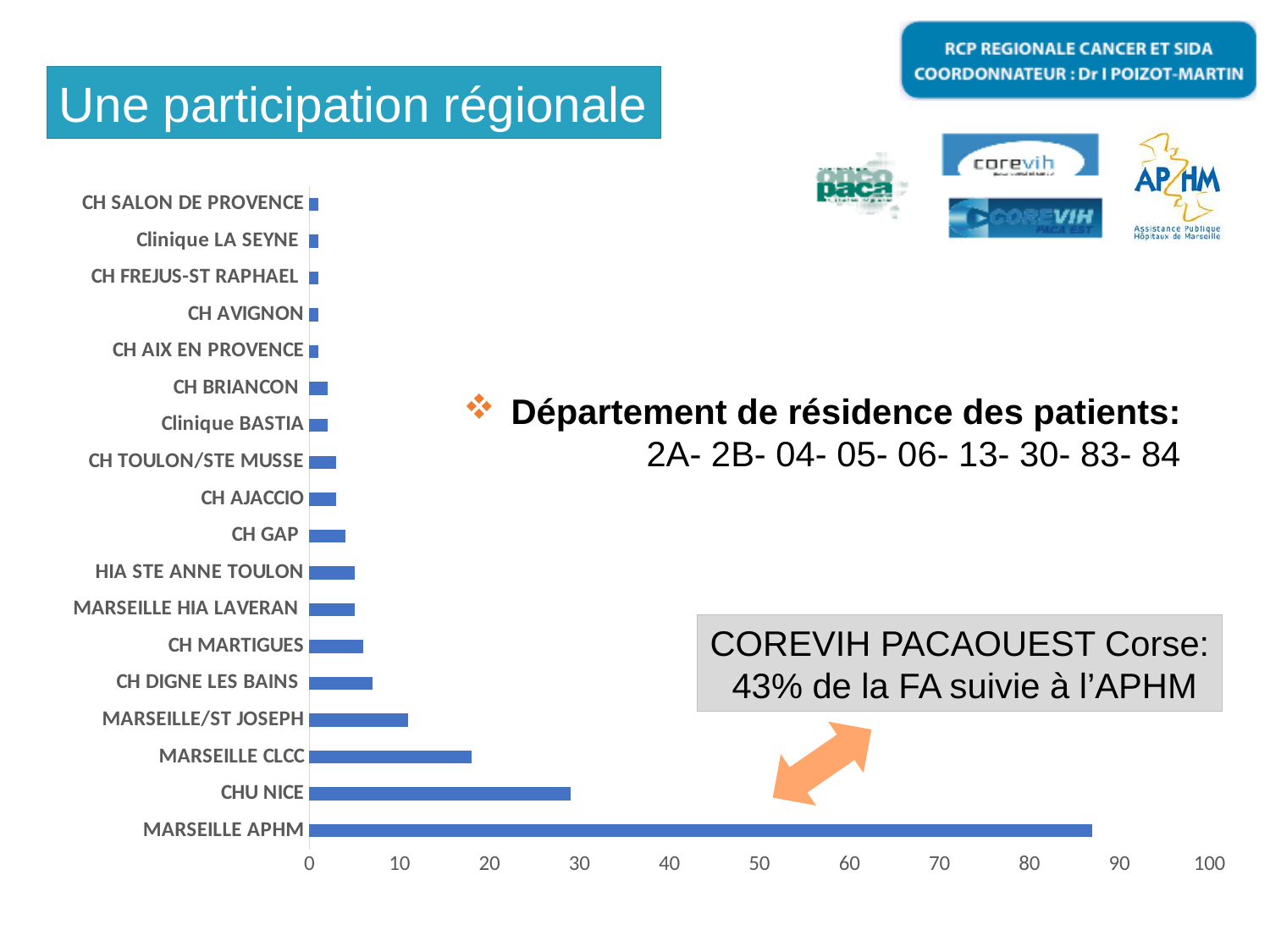
Which has the larger value, CHU NICE or MARSEILLE CLCC? CHU NICE Is the value for MARSEILLE CLCC greater or less than 20? less Which centre has the highest value on the chart? MARSEILLE APHM What colour are the bars in the chart? blue What kind of chart is shown on the slide? bar chart What is the highest value shown on the horizontal axis of the chart? 100 Which has the larger value, CH DIGNE LES BAINS or CH GAP? CH DIGNE LES BAINS Is the value for MARSEILLE APHM greater or less than 80? greater How many categories (centres) are listed on the chart? 18 Is the value for CHU NICE greater or less than 20? greater